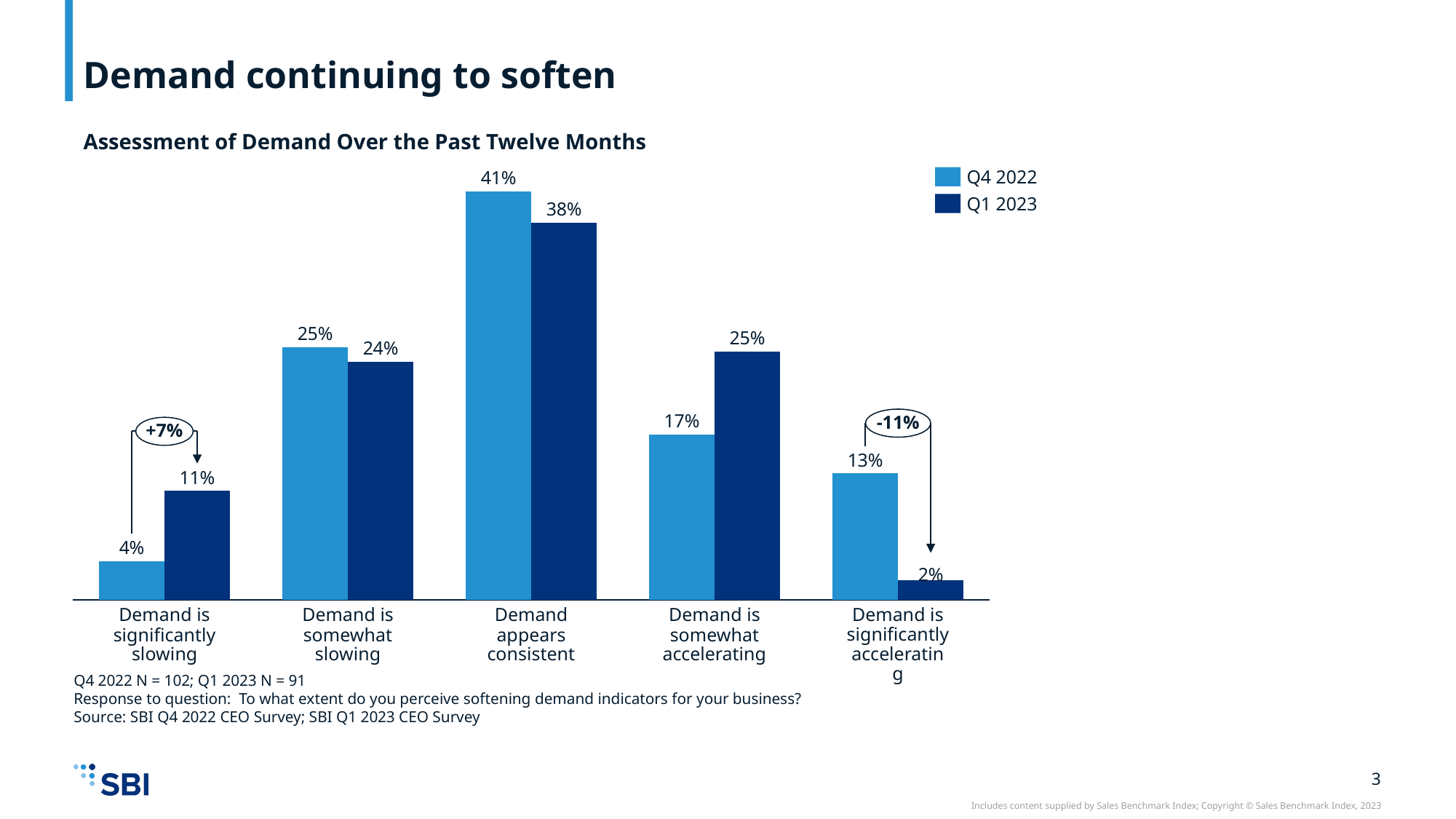
What kind of chart is shown on the slide? Bar chart What is the difference between the Q4 2022 and Q1 2023 values for "Demand is significantly accelerating"? 11% What is the difference between the Q4 2022 and Q1 2023 values for "Demand appears consistent"? 3% Which category has the highest Q1 2023 value? Demand appears consistent How many categories are shown on the x axis? 5 What is the Q4 2022 value for "Demand appears consistent"? 41% What is the title of the chart? Assessment of Demand Over the Past Twelve Months How many series does the legend list? 2 Which is larger for "Demand is somewhat accelerating": the Q4 2022 value or the Q1 2023 value? Q1 2023 What is the Q1 2023 value for "Demand is significantly slowing"? 11% Which category has the lowest Q4 2022 value? Demand is significantly slowing What is the Q1 2023 value for "Demand is somewhat accelerating"? 25%